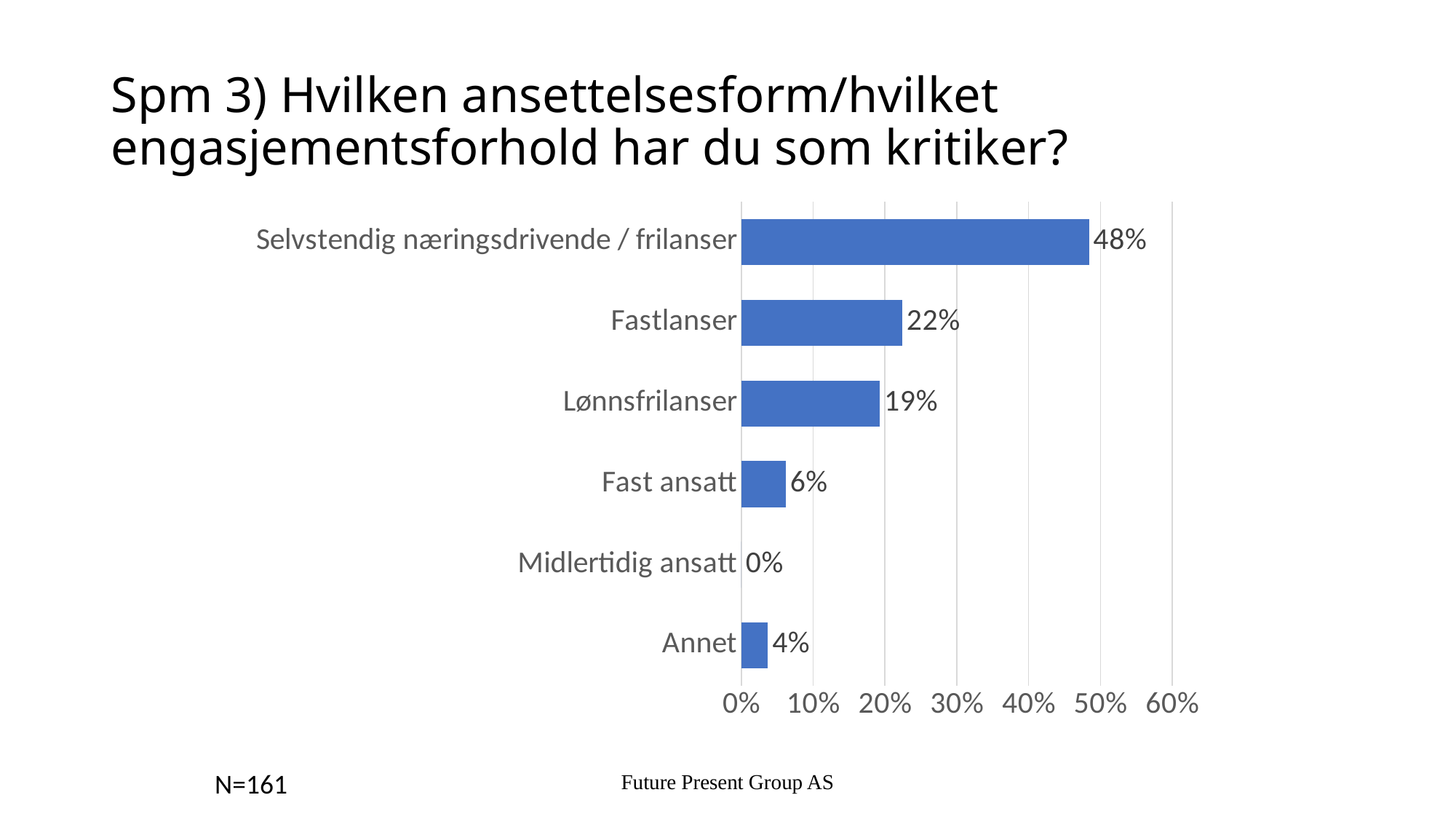
What is the value for Fastlanser? 22% What kind of chart is shown on the slide? Bar chart How many categories are shown in the chart? 6 Which category has the lowest value? Midlertidig ansatt What is the value for Fast ansatt? 6% What is the value for Midlertidig ansatt? 0% What is the difference between the values for Selvstendig næringsdrivende / frilanser and Fastlanser? 26% What is the value for Lønnsfrilanser? 19% What is the sample size (N) stated on the slide? N=161 Which category has the highest value? Selvstendig næringsdrivende / frilanser Which is larger, the value for Fast ansatt or the value for Annet? Fast ansatt What is the value for Selvstendig næringsdrivende / frilanser? 48%